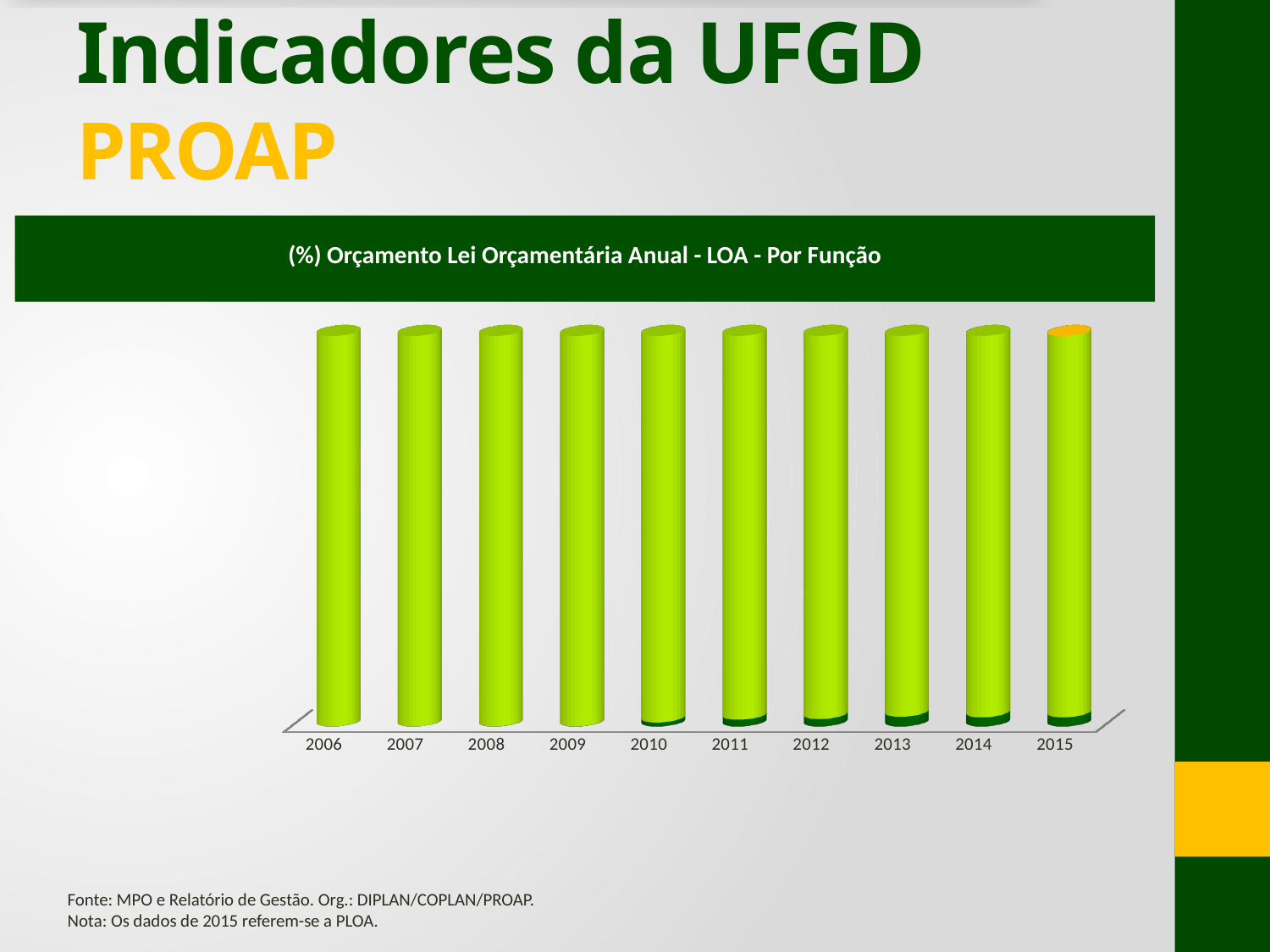
What is the title of the chart? (%) Orçamento Lei Orçamentária Anual - LOA - Por Função What kind of chart is shown on the slide? bar chart What is the first year shown on the x axis of the chart? 2006 Which year's bar has a yellow top in the chart? 2015 How many years are shown along the x axis of the chart? 10 What is the last year shown on the x axis of the chart? 2015